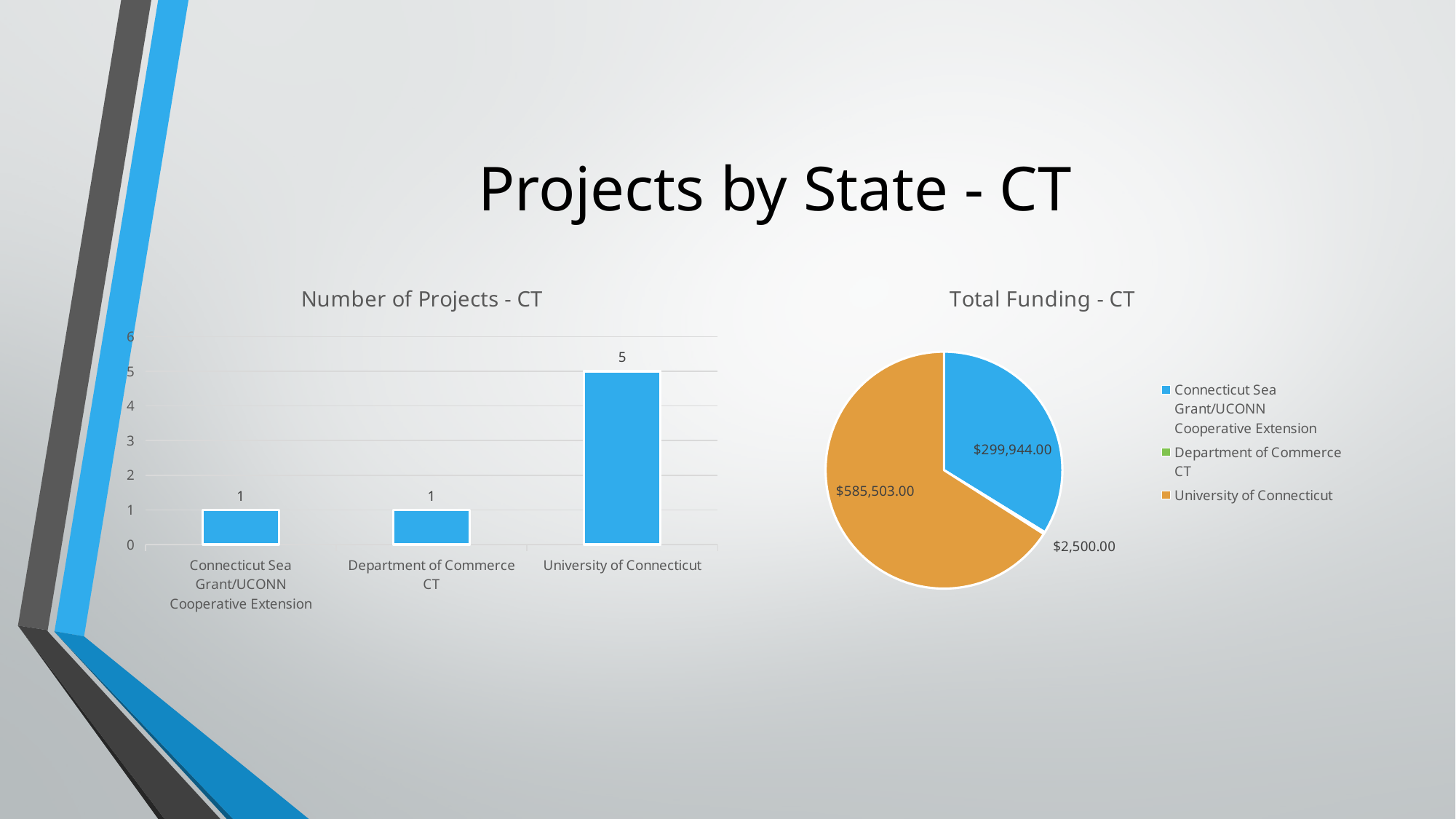
How many entries does the legend of the 'Total Funding - CT' chart list? 3 In the 'Total Funding - CT' chart, what is the difference in funding between University of Connecticut and Connecticut Sea Grant/UCONN Cooperative Extension? $285,559.00 In the 'Number of Projects - CT' chart, which category has the highest number of projects? University of Connecticut What type of chart is 'Total Funding - CT'? Pie chart In the 'Total Funding - CT' chart, which organization has the smallest funding? Department of Commerce CT In the 'Number of Projects - CT' chart, how many categories are shown on the x axis? 3 In the 'Number of Projects - CT' chart, how many projects does University of Connecticut have? 5 In the 'Number of Projects - CT' chart, what is the difference in projects between University of Connecticut and Connecticut Sea Grant/UCONN Cooperative Extension? 4 What type of chart is 'Number of Projects - CT'? Bar chart In the 'Number of Projects - CT' chart, how many projects does Department of Commerce CT have? 1 In the 'Total Funding - CT' chart, what is the funding value for Connecticut Sea Grant/UCONN Cooperative Extension? $299,944.00 In the 'Total Funding - CT' chart, what is the funding value for University of Connecticut? $585,503.00